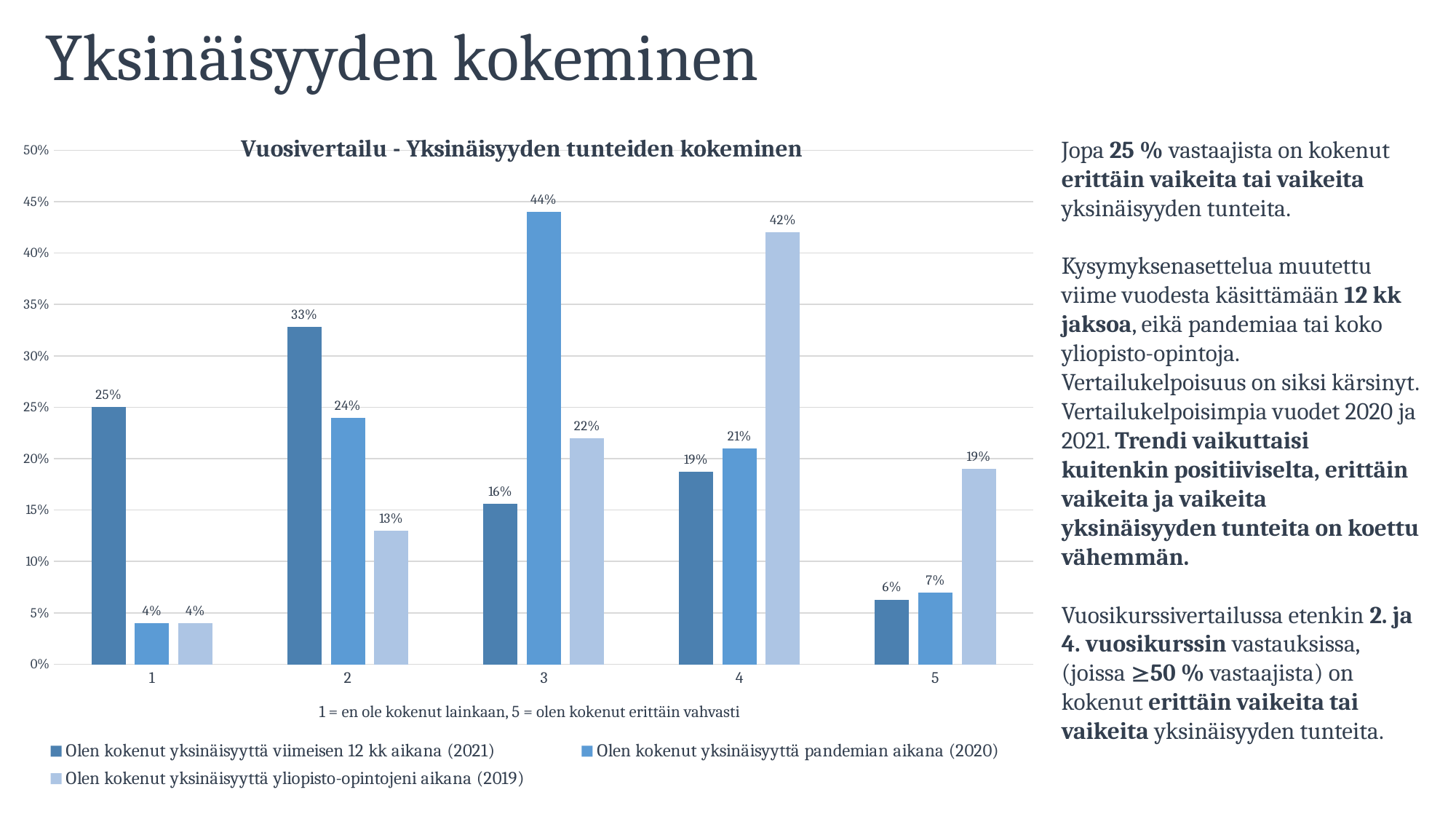
For category 2, which series has the larger value: 2021 or 2019? 2021 Which category has the highest value in the 2021 series ("Olen kokenut yksinäisyyttä viimeisen 12 kk aikana")? 2 Which category has the lowest value in the 2019 series ("Olen kokenut yksinäisyyttä yliopisto-opintojeni aikana")? 1 How many categories are shown on the x axis? 5 What is the title of the chart? Vuosivertailu - Yksinäisyyden tunteiden kokeminen Is the 2019 value for category 4 greater or less than 40%? greater What kind of chart is shown on the slide? bar chart What is the value for category 3 in the series "Olen kokenut yksinäisyyttä pandemian aikana (2020)"? 44% What is the difference between the 2020 value and the 2021 value for category 3? 28% What is the value for category 4 in the series "Olen kokenut yksinäisyyttä yliopisto-opintojeni aikana (2019)"? 42% What is the value for category 1 in the series "Olen kokenut yksinäisyyttä viimeisen 12 kk aikana (2021)"? 25% How many series does the legend list? 3